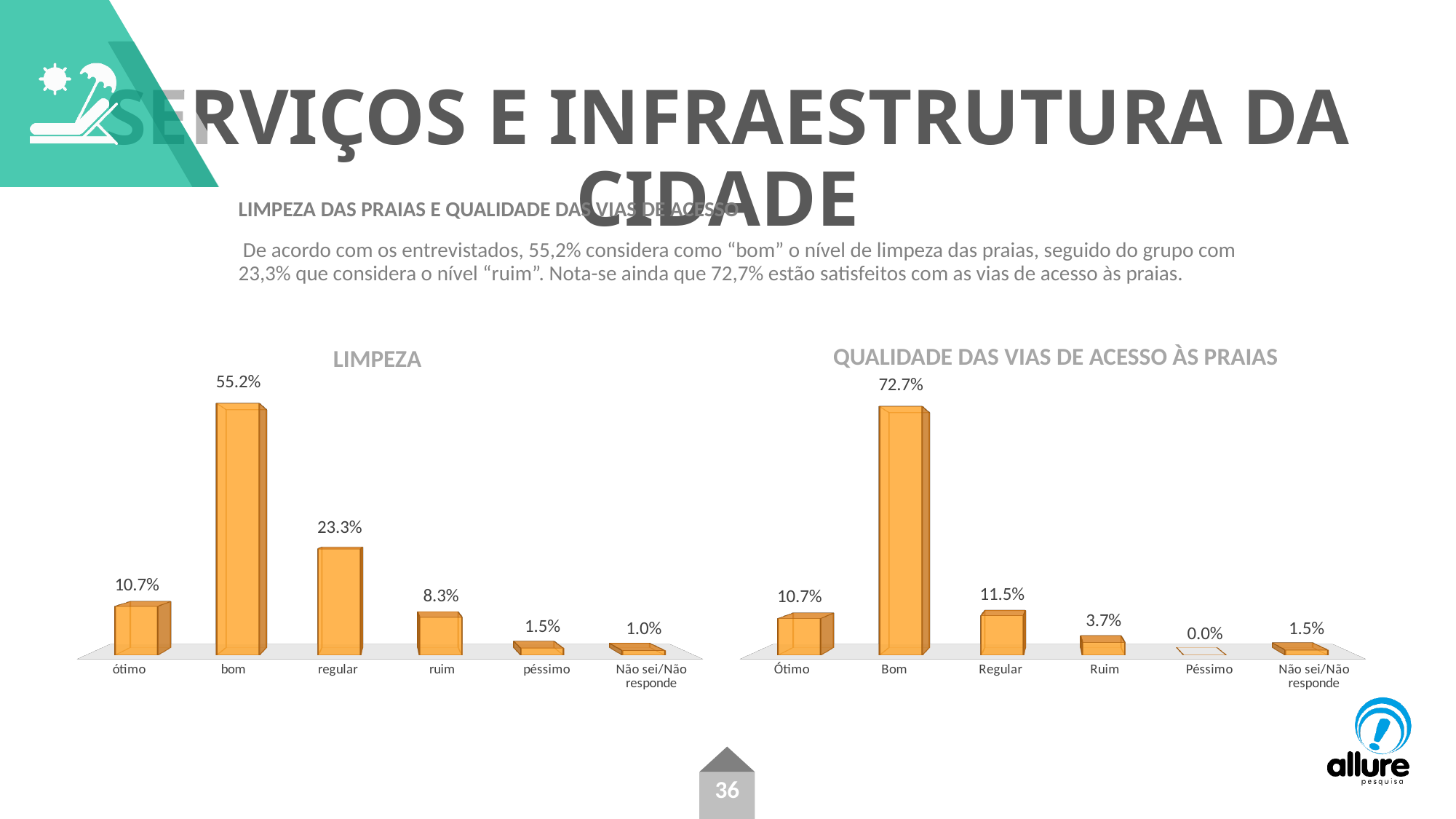
In the QUALIDADE DAS VIAS DE ACESSO ÀS PRAIAS chart, what is the value for "Péssimo"? 0.0% What kind of chart is the LIMPEZA chart? Bar chart In the LIMPEZA chart, what is the difference between the values for "bom" and "regular"? 31.9% In the LIMPEZA chart, which category has the highest value? bom In the LIMPEZA chart, which category has the lowest value? Não sei/Não responde In the QUALIDADE DAS VIAS DE ACESSO ÀS PRAIAS chart, which category has the lowest value? Péssimo How many categories does the QUALIDADE DAS VIAS DE ACESSO ÀS PRAIAS chart show? 6 In the LIMPEZA chart, what is the value for "ruim"? 8.3% In the QUALIDADE DAS VIAS DE ACESSO ÀS PRAIAS chart, what is the value for "Regular"? 11.5% In the QUALIDADE DAS VIAS DE ACESSO ÀS PRAIAS chart, what is the difference between the values for "Bom" and "Ótimo"? 62.0% In the LIMPEZA chart, what is the value for "bom"? 55.2% In the LIMPEZA chart, which is larger: the value for "ótimo" or the value for "ruim"? ótimo